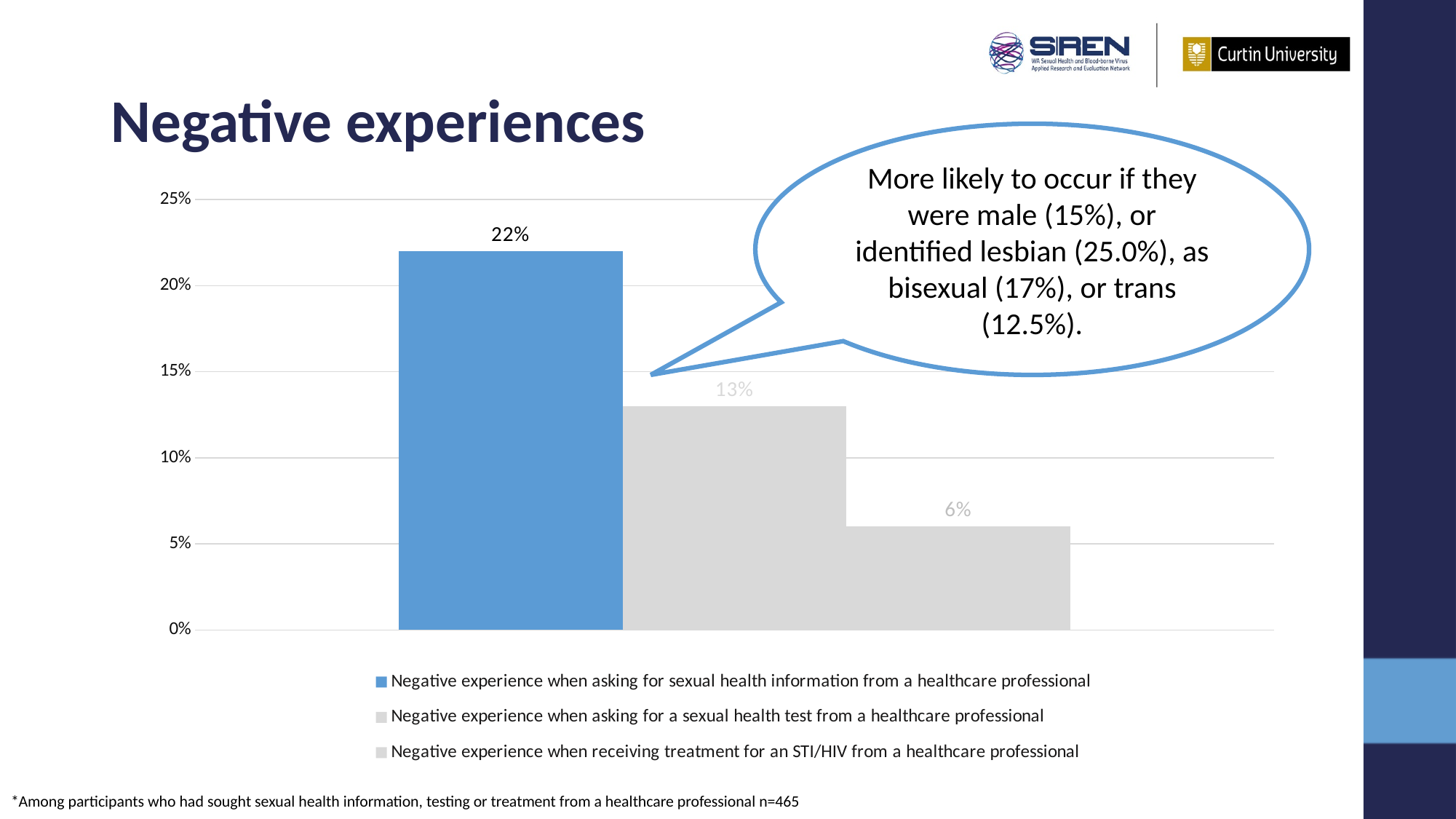
Is the value for negative experiences when asking for sexual health information greater or less than 20%? greater What colour is the bar for negative experiences when asking for sexual health information from a healthcare professional? Blue Which series has the highest value on the chart? Negative experience when asking for sexual health information from a healthcare professional What is the difference between the value for negative experiences when asking for a sexual health test and the value for negative experiences when receiving treatment for an STI/HIV? 7% What percentage of participants reported a negative experience when asking for a sexual health test from a healthcare professional? 13% What percentage of participants reported a negative experience when asking for sexual health information from a healthcare professional? 22% What is the difference between the value for negative experiences when asking for sexual health information and the value for negative experiences when asking for a sexual health test? 9% What kind of chart is shown on the slide? Bar chart Which is larger: the value for negative experiences when asking for a sexual health test or the value for negative experiences when receiving treatment for an STI/HIV? Negative experience when asking for a sexual health test from a healthcare professional What percentage of participants reported a negative experience when receiving treatment for an STI/HIV from a healthcare professional? 6% How many series does the legend list? 3 Which series has the lowest value on the chart? Negative experience when receiving treatment for an STI/HIV from a healthcare professional